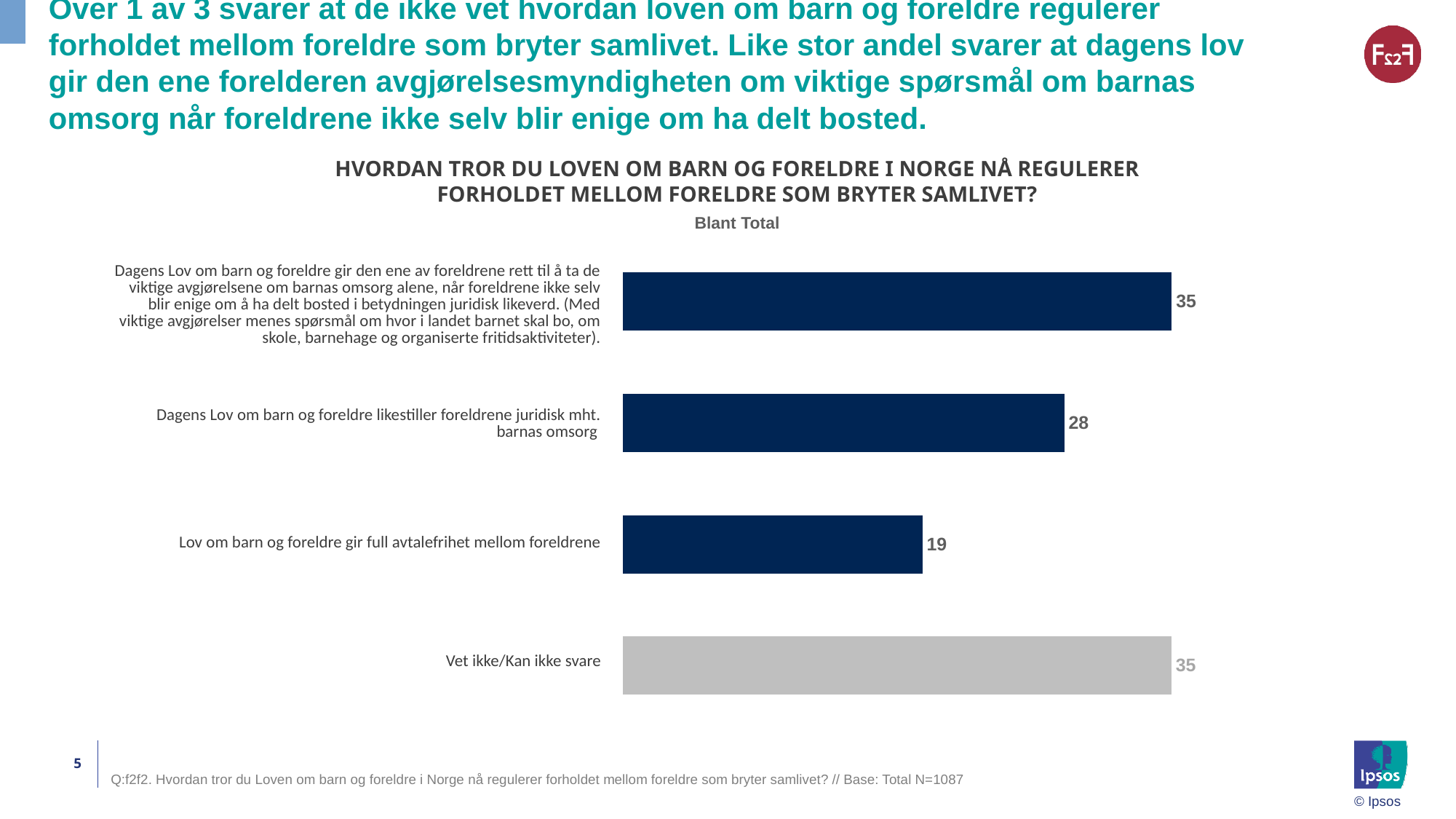
What value is shown for "Lov om barn og foreldre gir full avtalefrihet mellom foreldrene"? 19 Which bar is shown in grey rather than dark blue? Vet ikke/Kan ikke svare What is the subtitle shown directly above the bars? Blant Total What is the difference between the value for "Vet ikke/Kan ikke svare" and the value for "Dagens Lov om barn og foreldre likestiller foreldrene juridisk mht. barnas omsorg"? 7 What value is shown for "Vet ikke/Kan ikke svare"? 35 What kind of chart is shown on the slide? Bar chart What is the difference between the value for "Dagens Lov om barn og foreldre likestiller foreldrene juridisk mht. barnas omsorg" and the value for "Lov om barn og foreldre gir full avtalefrihet mellom foreldrene"? 9 Which category has the lowest value? Lov om barn og foreldre gir full avtalefrihet mellom foreldrene How many categories (bars) does the chart show? 4 Which is larger: the value for "Dagens Lov om barn og foreldre likestiller foreldrene juridisk mht. barnas omsorg" or the value for "Lov om barn og foreldre gir full avtalefrihet mellom foreldrene"? Dagens Lov om barn og foreldre likestiller foreldrene juridisk mht. barnas omsorg What value is shown for the first (top) bar, the statement that the law gives one parent the right to make important decisions alone? 35 What value is shown for "Dagens Lov om barn og foreldre likestiller foreldrene juridisk mht. barnas omsorg"? 28